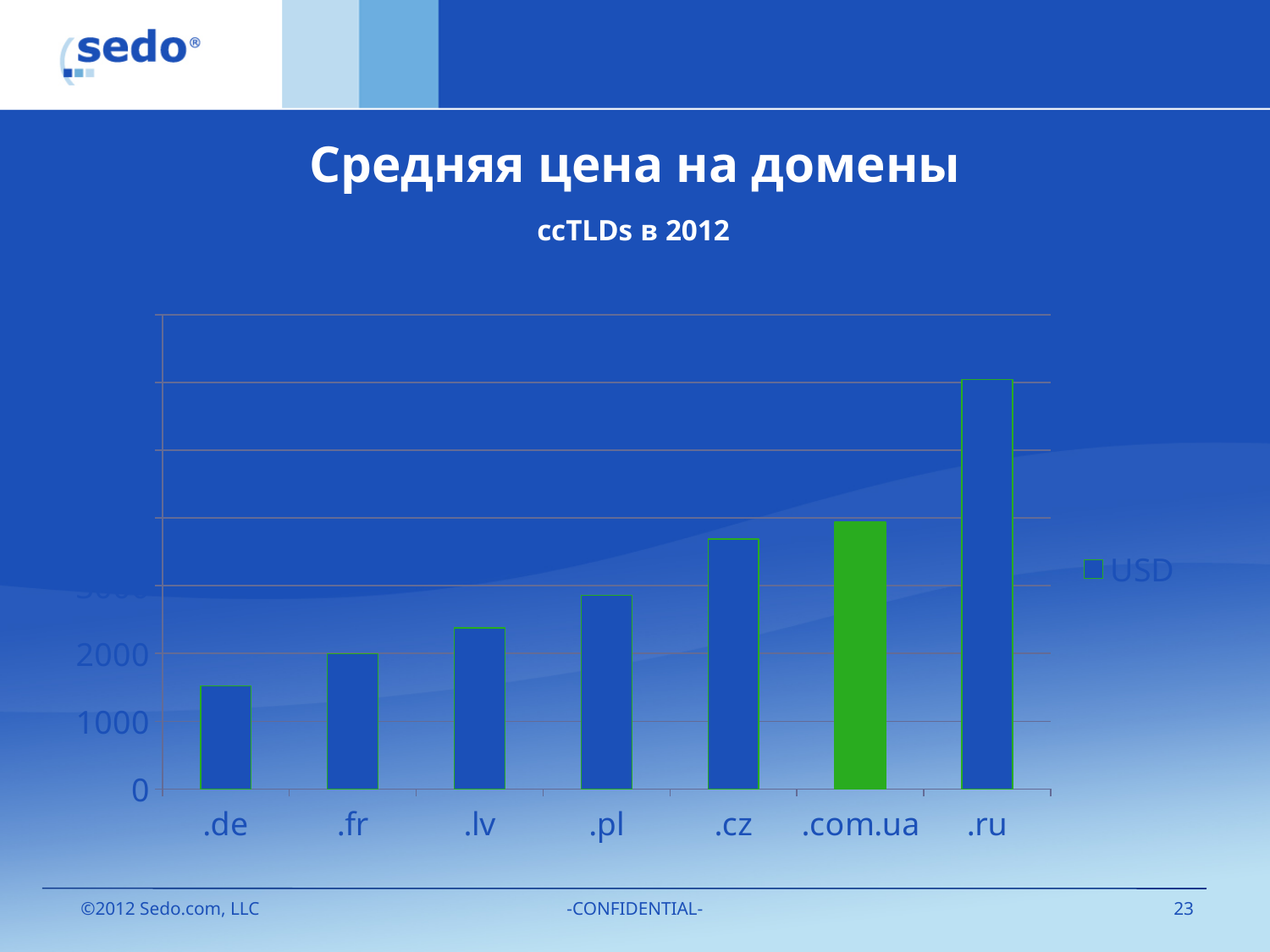
Which is larger, the value for .ru or the value for .com.ua? .ru How many ccTLD categories are plotted on the chart? 7 How many series does the legend list? 1 Which is larger, the value for .cz or the value for .pl? .cz Which ccTLD has the highest average price? .ru Is the value for .de greater or less than 1000? greater What kind of chart is shown on the slide? bar chart Is the value for .lv greater or less than 2000? greater Do the values rise or fall from left to right along the x axis? rise Is the value for .de greater or less than 2000? less Which ccTLD has the lowest average price? .de What is the legend entry shown on the chart? USD